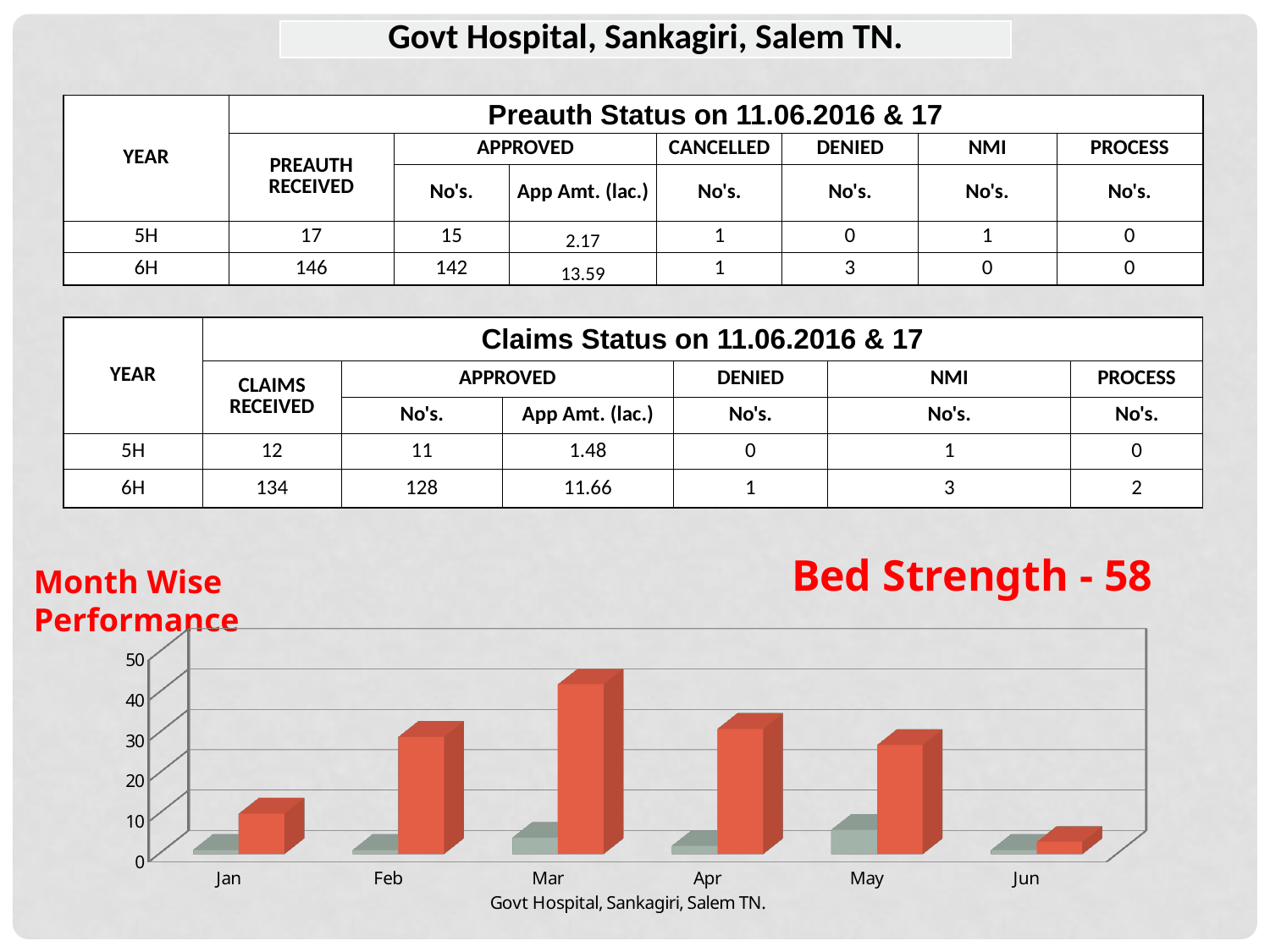
What text appears below the x axis of the chart? Govt Hospital, Sankagiri, Salem TN. Which month has the tallest red bar in the chart? Mar Is the red bar for Feb greater or less than 20? greater Which month has the larger red bar, Jan or Apr? Apr Is the red bar for Mar greater or less than 30? greater Which month has the shortest red bar in the chart? Jun What kind of chart is shown at the bottom of the slide? bar chart How many months are shown on the x axis of the chart? 6 Is the red bar for Jan greater or less than 20? less What is the highest value shown on the chart's vertical axis? 50 Which month has the larger red bar, Feb or Mar? Mar